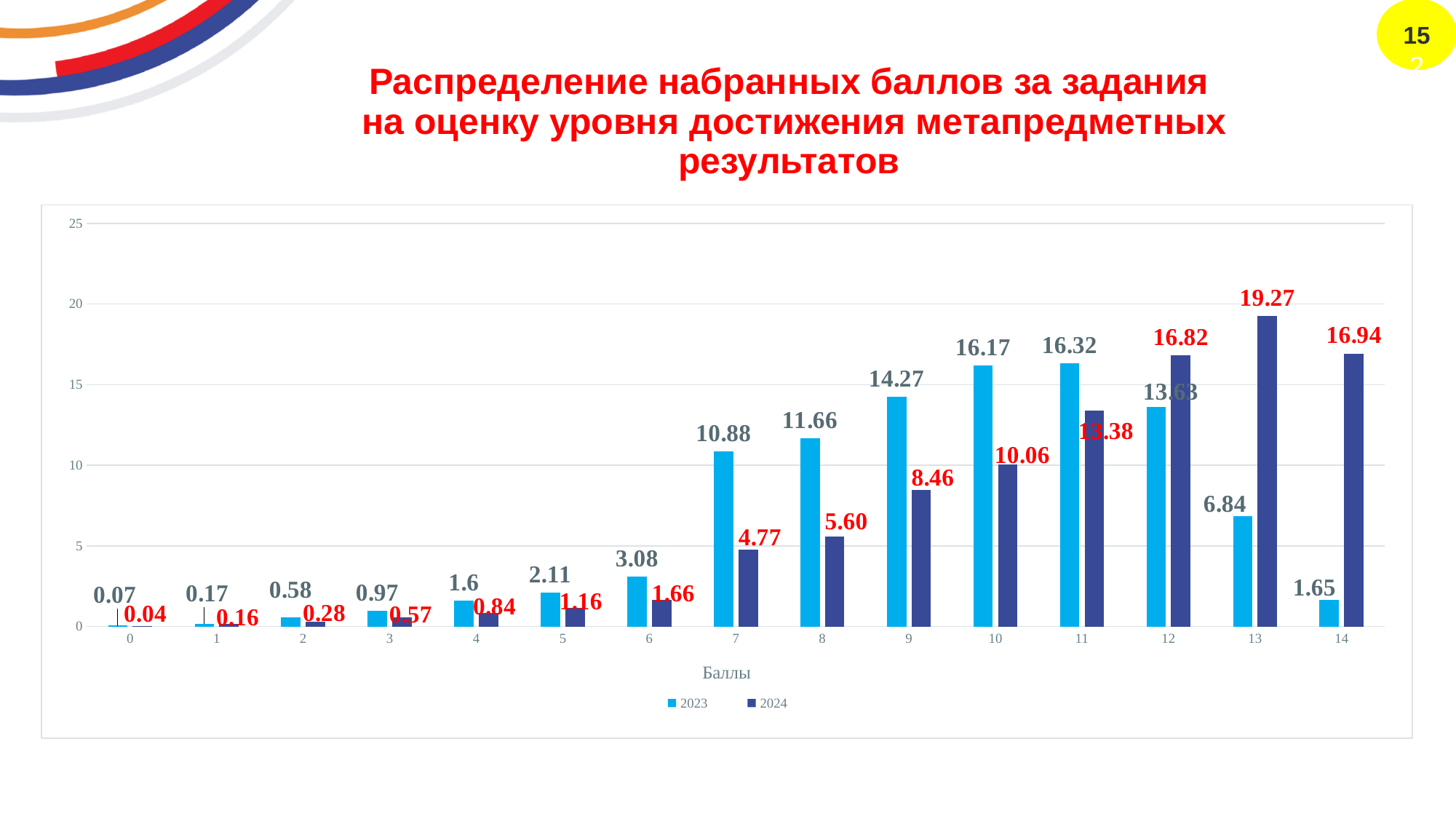
What kind of chart is shown on the slide? bar chart Is the value for 2023 at score 13 greater or less than 10? less What is the difference between the 2023 and 2024 values at score 7? 6.11 How many series does the legend list? 2 What is the value for 2024 at score 8? 5.60 Which score has the highest value for the 2024 series? 13 How many score categories are shown on the x axis? 15 At score 9, which series has the larger value, 2023 or 2024? 2023 Which score has the lowest value for the 2023 series? 0 What is the difference between the 2023 and 2024 values at score 14? 15.29 What is the value for 2023 at score 7? 10.88 What is the value for 2024 at score 13? 19.27